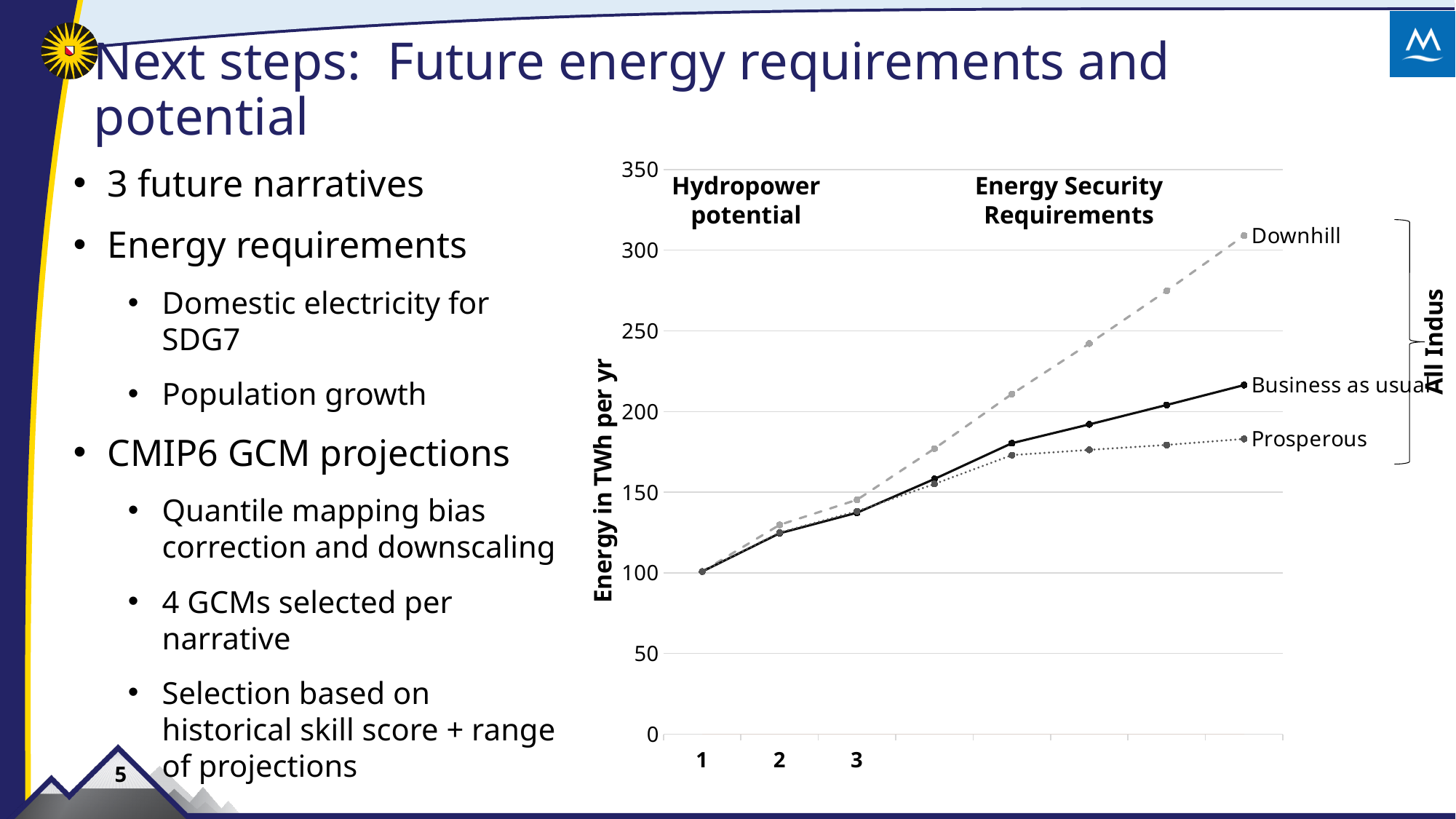
Is the final value of the Downhill series greater or less than 300? greater Which series reaches the highest value at the right end of the chart? Downhill Is the final value of the Prosperous series greater or less than 200? less How many series are plotted on the chart? 3 Is the value of the Downhill series at x = 2 greater or less than 150? less What is the title of the vertical axis of the chart? Energy in TWh per yr At the right end of the chart, which is larger: the Downhill value or the Prosperous value? Downhill What are the two bold labels printed above the plotted lines? Hydropower potential; Energy Security Requirements What kind of chart is shown on the slide? line chart Which series has the lowest value at the right end of the chart? Prosperous Do the values of the Downhill series rise or fall along the x axis? rise